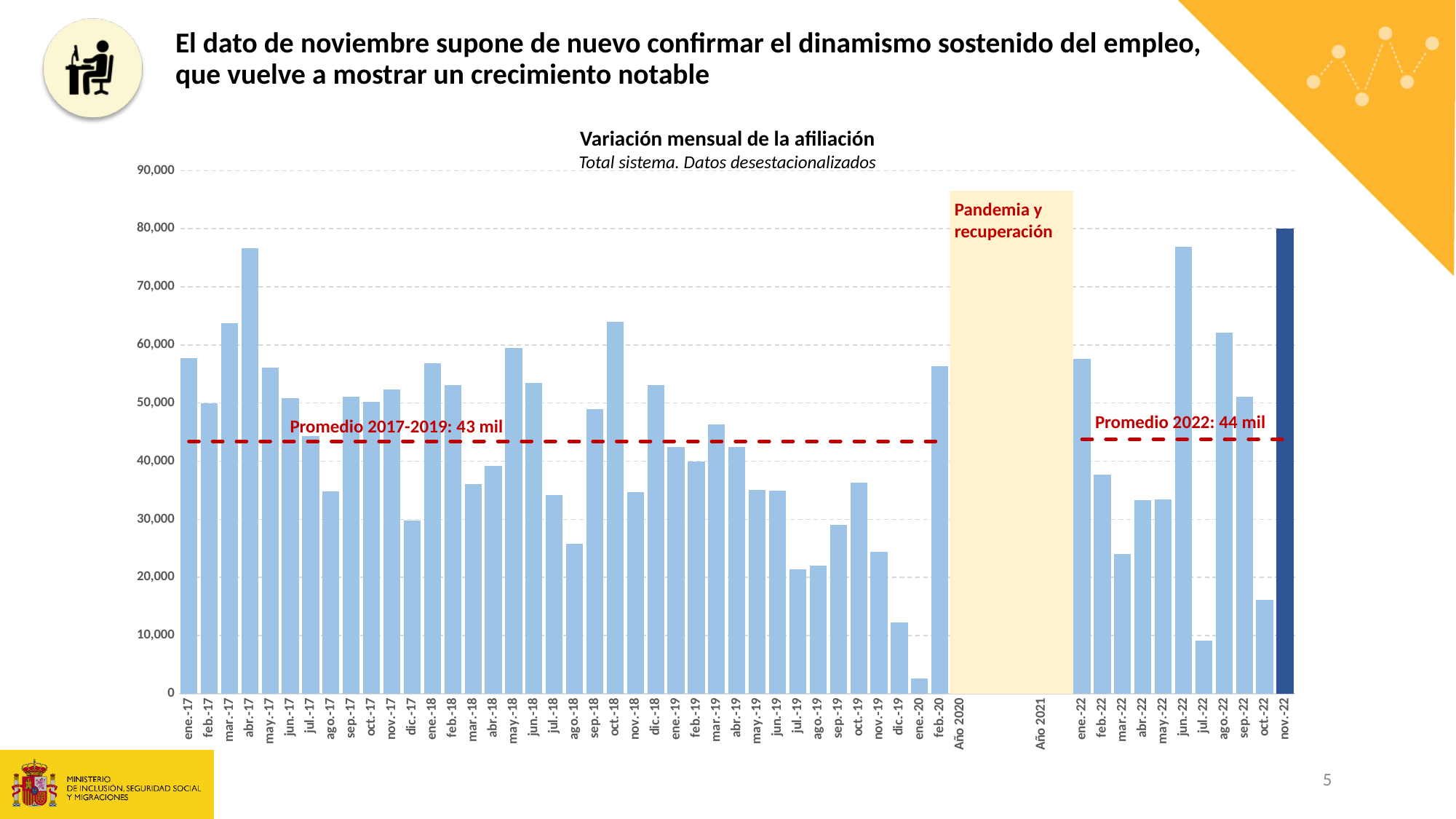
What average value is shown for 2022 by the dashed line? 44 mil Is the value for nov.-22 greater or less than 70,000? greater What label is written in the shaded area covering Año 2020 and Año 2021? Pandemia y recuperación Which month has the lowest bar in the chart? ene.-20 Is the value for jul.-22 greater or less than 10,000? less What kind of chart is shown on the slide? bar chart Which is larger, the value for jun.-22 or the value for jul.-22? jun.-22 What is the title of the chart? Variación mensual de la afiliación Which month has the highest bar in the chart? nov.-22 What average value is shown for the period 2017-2019 by the dashed line? 43 mil Is the value for ago.-18 greater or less than 30,000? less